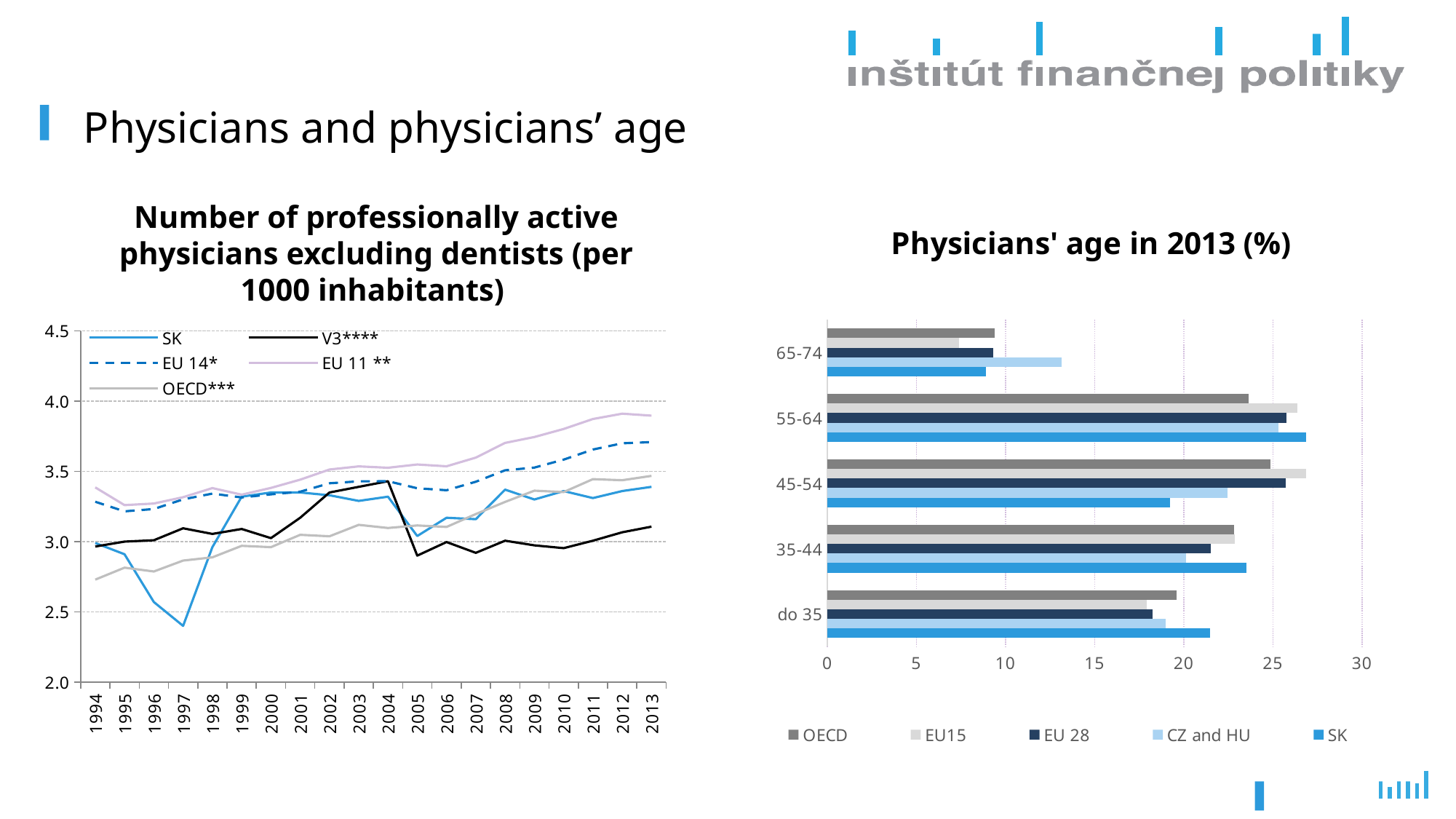
In the 'Physicians' age in 2013 (%)' chart, which is larger for the 45-54 group, EU15 or SK? EU15 How many series does the legend of the 'Number of professionally active physicians excluding dentists' chart list? 5 What kind of chart is the 'Number of professionally active physicians excluding dentists (per 1000 inhabitants)' chart? line chart In the 'Physicians' age in 2013 (%)' chart, is the SK value for the 55-64 group greater or less than 25? greater In the 'Number of professionally active physicians excluding dentists' chart, is the SK value in 1997 greater or less than 2.5? less What kind of chart is the 'Physicians' age in 2013 (%)' chart? bar chart How many series does the legend of the 'Physicians' age in 2013 (%)' chart list? 5 In the 'Physicians' age in 2013 (%)' chart, which series has the highest value for the 55-64 group? SK In the 'Number of professionally active physicians excluding dentists' chart, is the EU 11 ** value in 2013 greater or less than 3.5? greater In the 'Number of professionally active physicians excluding dentists' chart, in which year does the SK series reach its lowest value? 1997 How many age categories are shown on the 'Physicians' age in 2013 (%)' chart? 5 In the 'Number of professionally active physicians excluding dentists' chart, which series has the highest value in 2013? EU 11 **